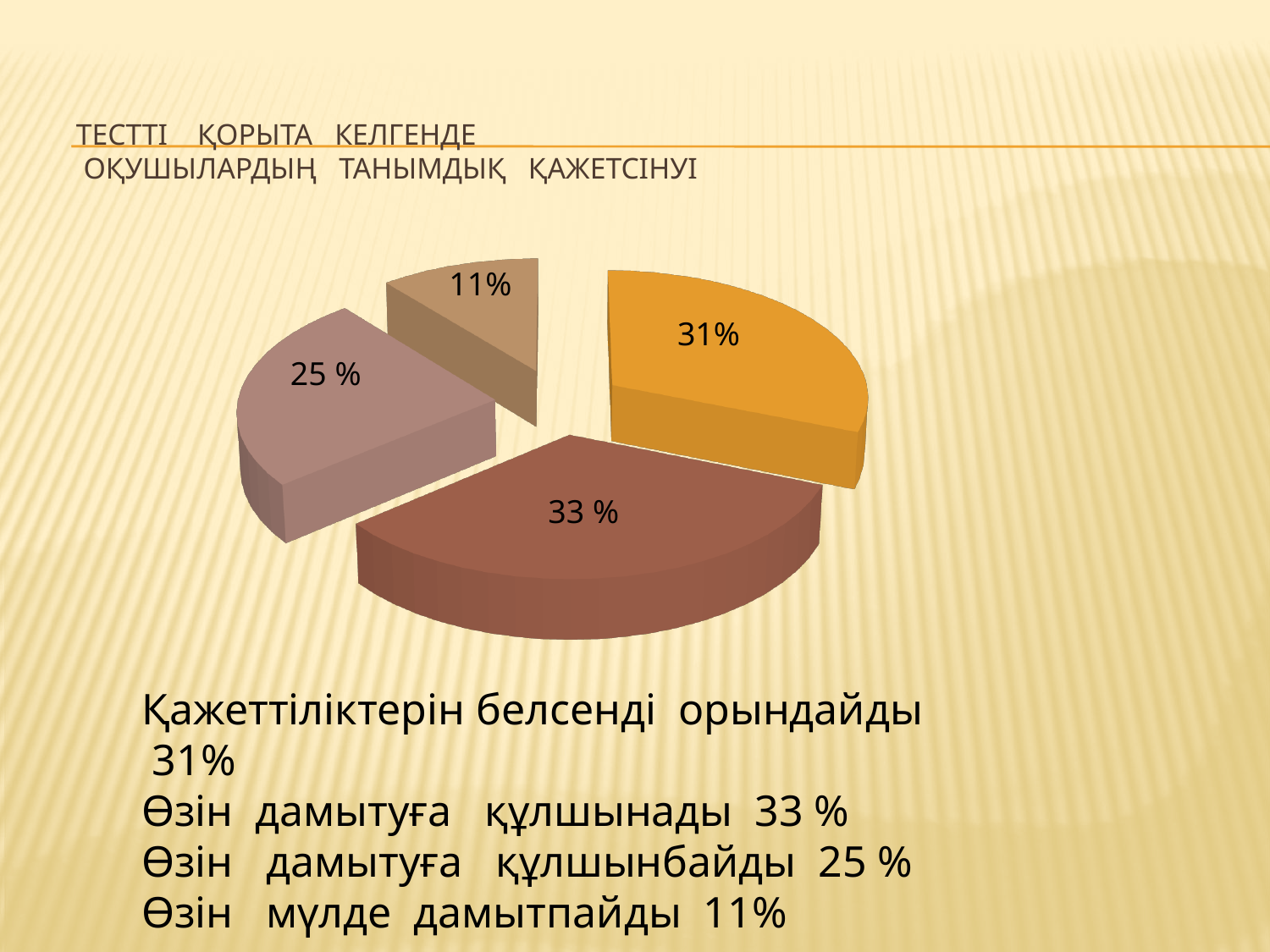
What percentage is shown for the pinkish-grey slice of the pie chart? 25 % What percentage is shown for the orange slice of the pie chart? 31% What percentage is shown for the dark brown slice of the pie chart? 33 % What percentage is shown for the tan slice of the pie chart? 11% What kind of chart is shown on the slide? pie chart According to the slide, what share corresponds to "Өзін мүлде дамытпайды"? 11% What is the largest slice of the pie chart? 33 % Which slice is larger, the orange one or the tan one? the orange one (31%) How many slices does the pie chart have? 4 What is the smallest slice of the pie chart? 11% According to the slide, what share corresponds to "Өзін дамытуға құлшынбайды"? 25 % What is the difference between the 33 % slice and the 25 % slice? 8 %